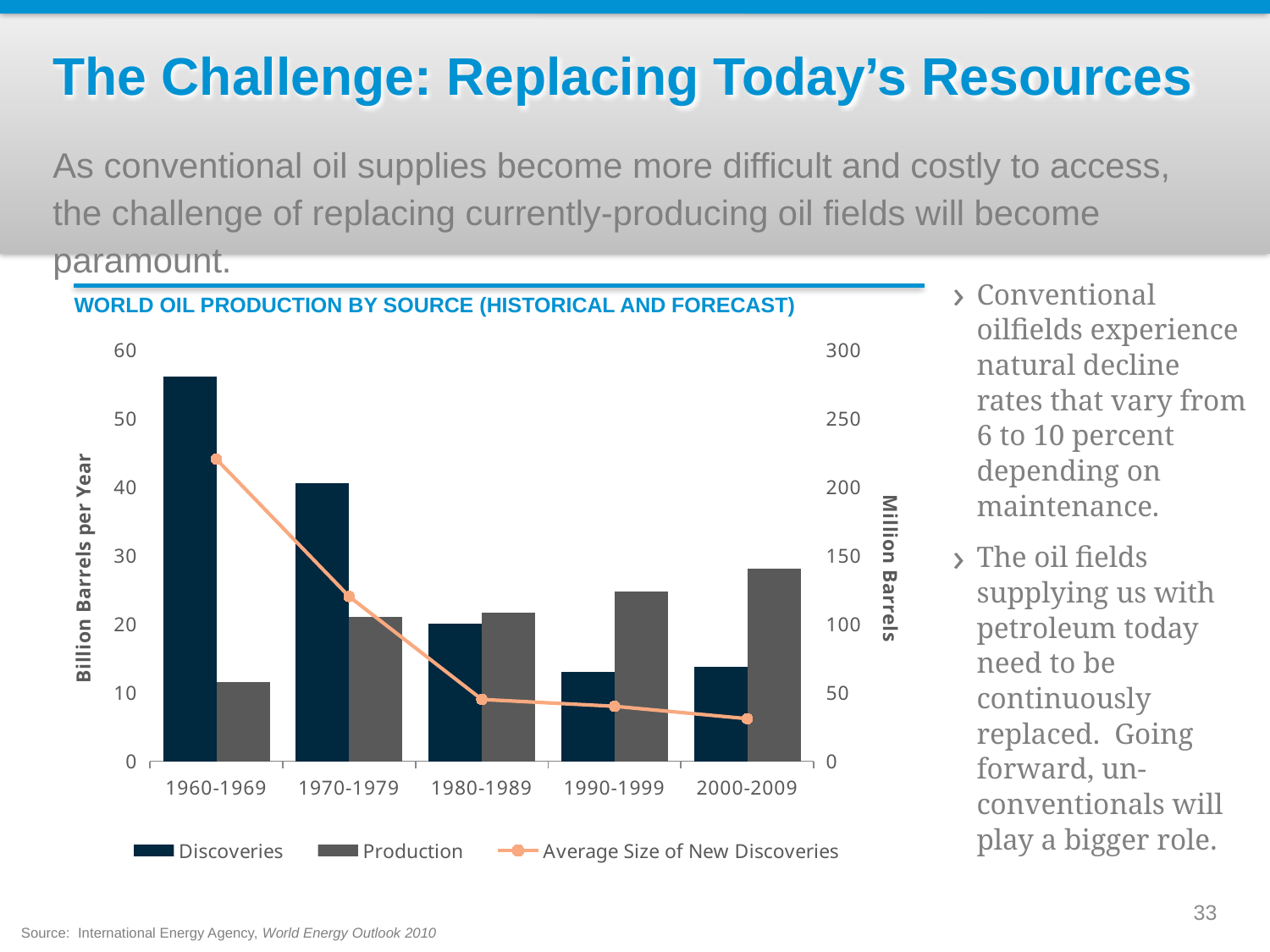
What kind of chart is shown on the slide? A bar chart with a line Is the Production value for 1960-1969 greater or less than 20? less How many series does the legend list? 3 Does the Average Size of New Discoveries line rise or fall from 1960-1969 to 2000-2009? Fall Which decade has the highest Discoveries value? 1960-1969 In 1960-1969, which is larger, Discoveries or Production? Discoveries What is the label on the right-hand vertical axis? Million Barrels In 2000-2009, which is larger, Discoveries or Production? Production How many decade categories are shown on the x axis? 5 Which decade has the lowest Production value? 1960-1969 Which decade has the highest Production value? 2000-2009 Is the Discoveries value for 1960-1969 greater or less than 50? greater